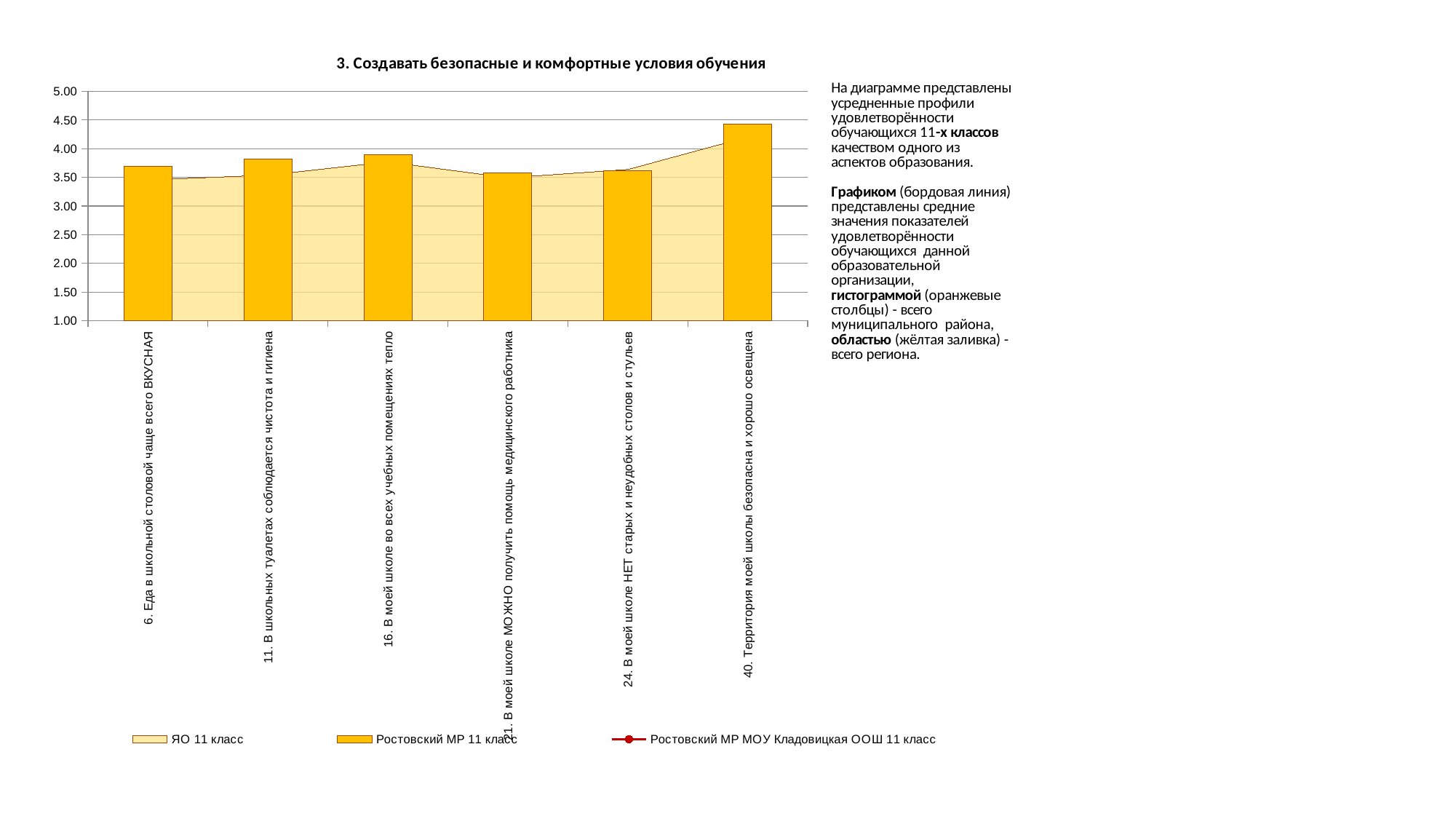
What is the title of the chart? 3. Создавать безопасные и комфортные условия обучения How many series does the chart legend list? 3 Which "Ростовский МР 11 класс" bar is taller: "16. В моей школе во всех учебных помещениях тепло" or "21. В моей школе МОЖНО получить помощь медицинского работника"? 16. В моей школе во всех учебных помещениях тепло Which category has the highest bar for "Ростовский МР 11 класс"? 40. Территория моей школы безопасна и хорошо освещена How many categories are shown on the x axis of the chart? 6 Is the "Ростовский МР 11 класс" bar for "11. В школьных туалетах соблюдается чистота и гигиена" greater or less than 3.00? greater Is the "Ростовский МР 11 класс" bar for "16. В моей школе во всех учебных помещениях тепло" greater or less than 4.00? less Which "Ростовский МР 11 класс" bar is taller: "40. Территория моей школы безопасна и хорошо освещена" or "24. В моей школе НЕТ старых и неудобных столов и стульев"? 40. Территория моей школы безопасна и хорошо освещена What kind of chart is used for the series "Ростовский МР 11 класс"? bar chart What colour are the bars for the series "Ростовский МР 11 класс"? orange Is the "Ростовский МР 11 класс" bar for "40. Территория моей школы безопасна и хорошо освещена" greater or less than 4.00? greater